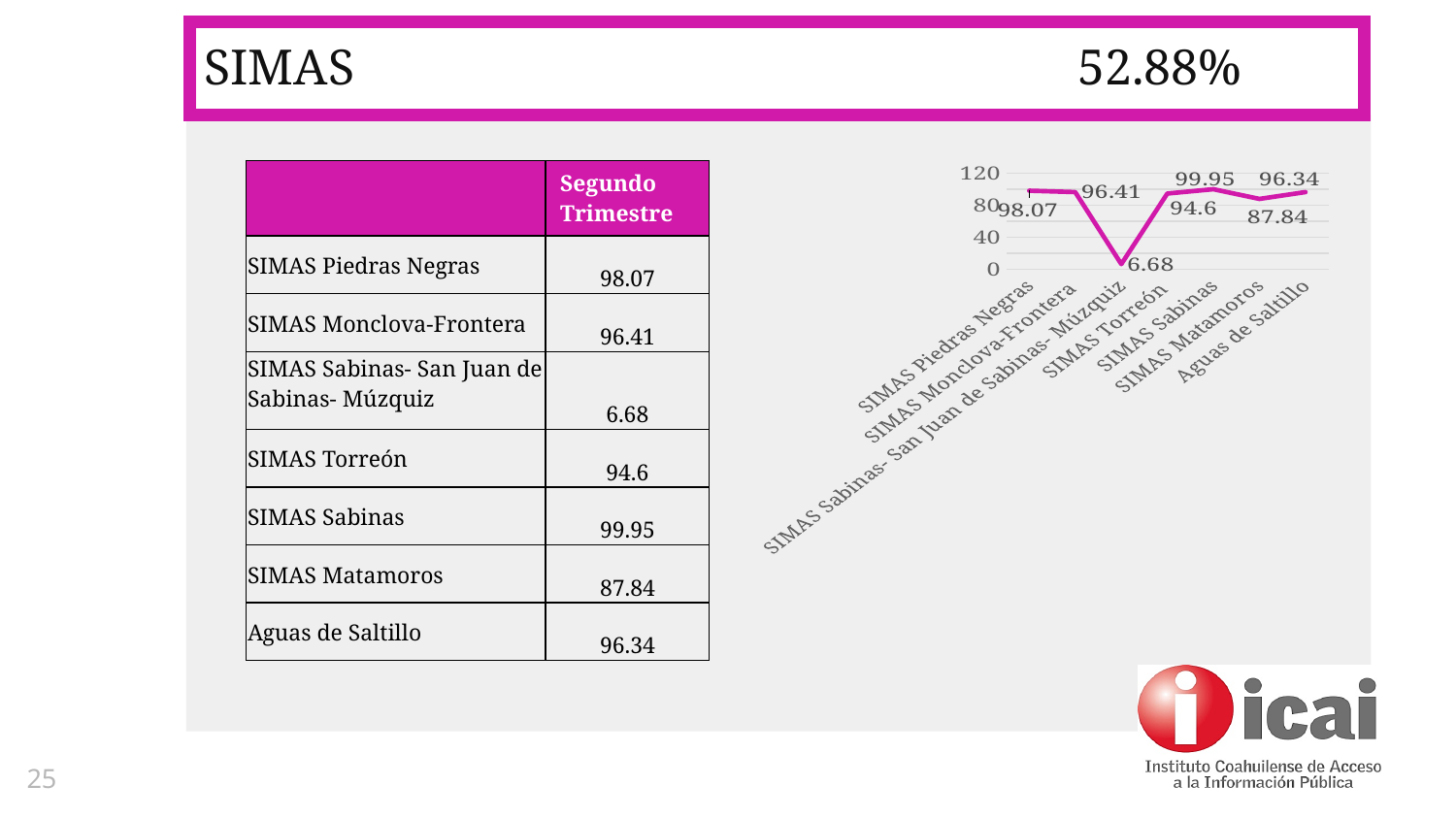
What kind of chart is shown on the slide? line chart Is the value for SIMAS Matamoros greater or less than 80? greater What colour is the line in the chart? magenta Which category has the lowest value in the chart? SIMAS Sabinas- San Juan de Sabinas- Múzquiz Which category has the highest value in the chart? SIMAS Sabinas Which is larger, the value for SIMAS Monclova-Frontera or the value for SIMAS Torreón? SIMAS Monclova-Frontera What is the value for SIMAS Torreón in the chart? 94.6 What is the highest value shown on the chart's vertical axis? 120 What is the difference between the values for SIMAS Sabinas and SIMAS Matamoros? 12.11 What is the value for Aguas de Saltillo in the chart? 96.34 How many categories are plotted in the chart? 7 What is the value for SIMAS Piedras Negras in the chart? 98.07